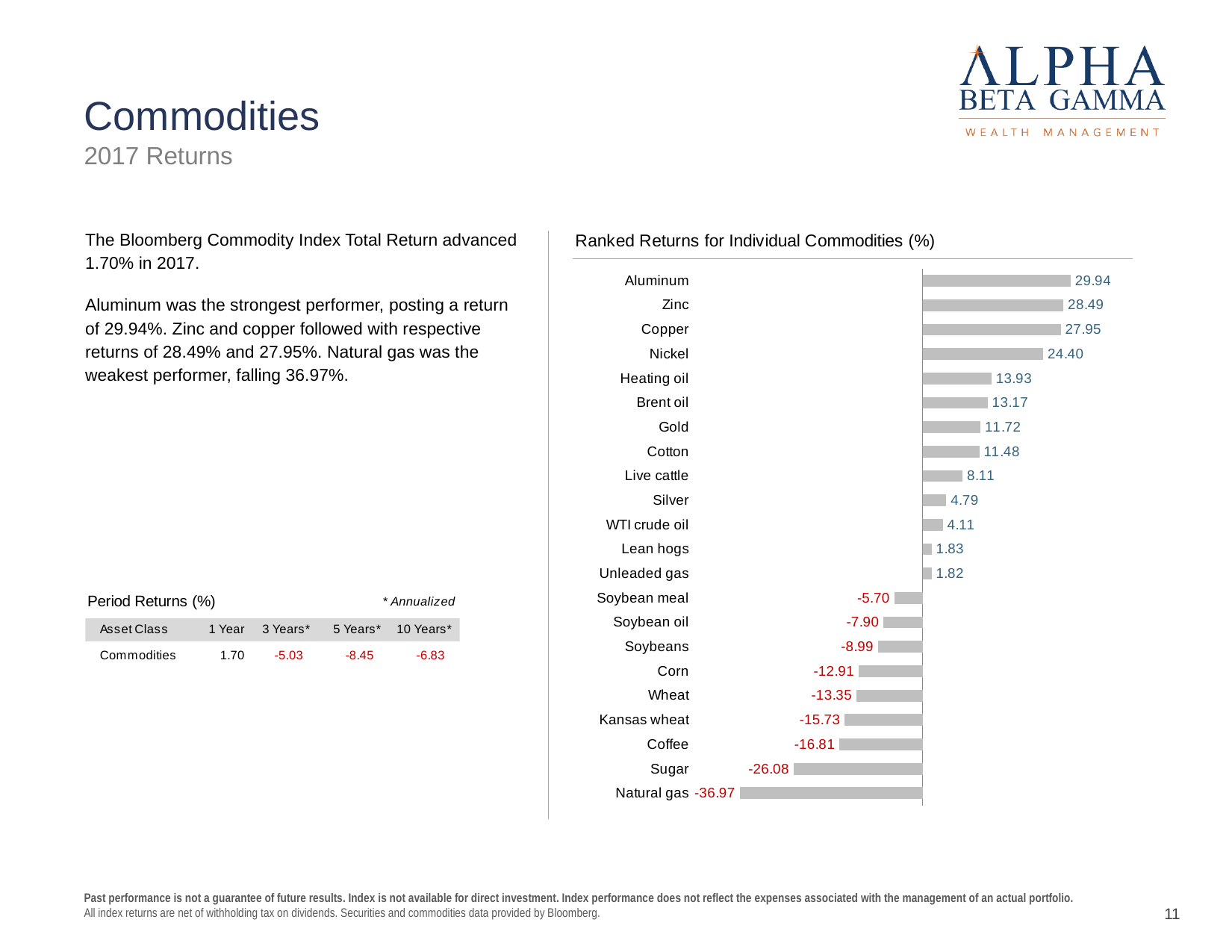
What is the difference between the returns for Sugar and Natural gas in the Ranked Returns for Individual Commodities chart? 10.89 What is the return shown for Gold in the Ranked Returns for Individual Commodities chart? 11.72 What is the title of the chart on the slide? Ranked Returns for Individual Commodities (%) Which commodity has the lowest return in the Ranked Returns for Individual Commodities chart? Natural gas In the Ranked Returns for Individual Commodities chart, which has the larger return, Corn or Wheat? Corn How many commodities are plotted in the Ranked Returns for Individual Commodities chart? 22 Which commodity has the highest return in the Ranked Returns for Individual Commodities chart? Aluminum What is the return shown for Coffee in the Ranked Returns for Individual Commodities chart? -16.81 In the Ranked Returns for Individual Commodities chart, which has the larger return, Heating oil or Brent oil? Heating oil What is the return shown for Nickel in the Ranked Returns for Individual Commodities chart? 24.40 What type of chart is the Ranked Returns for Individual Commodities chart? Bar chart What is the difference between the returns for Aluminum and Zinc in the Ranked Returns for Individual Commodities chart? 1.45